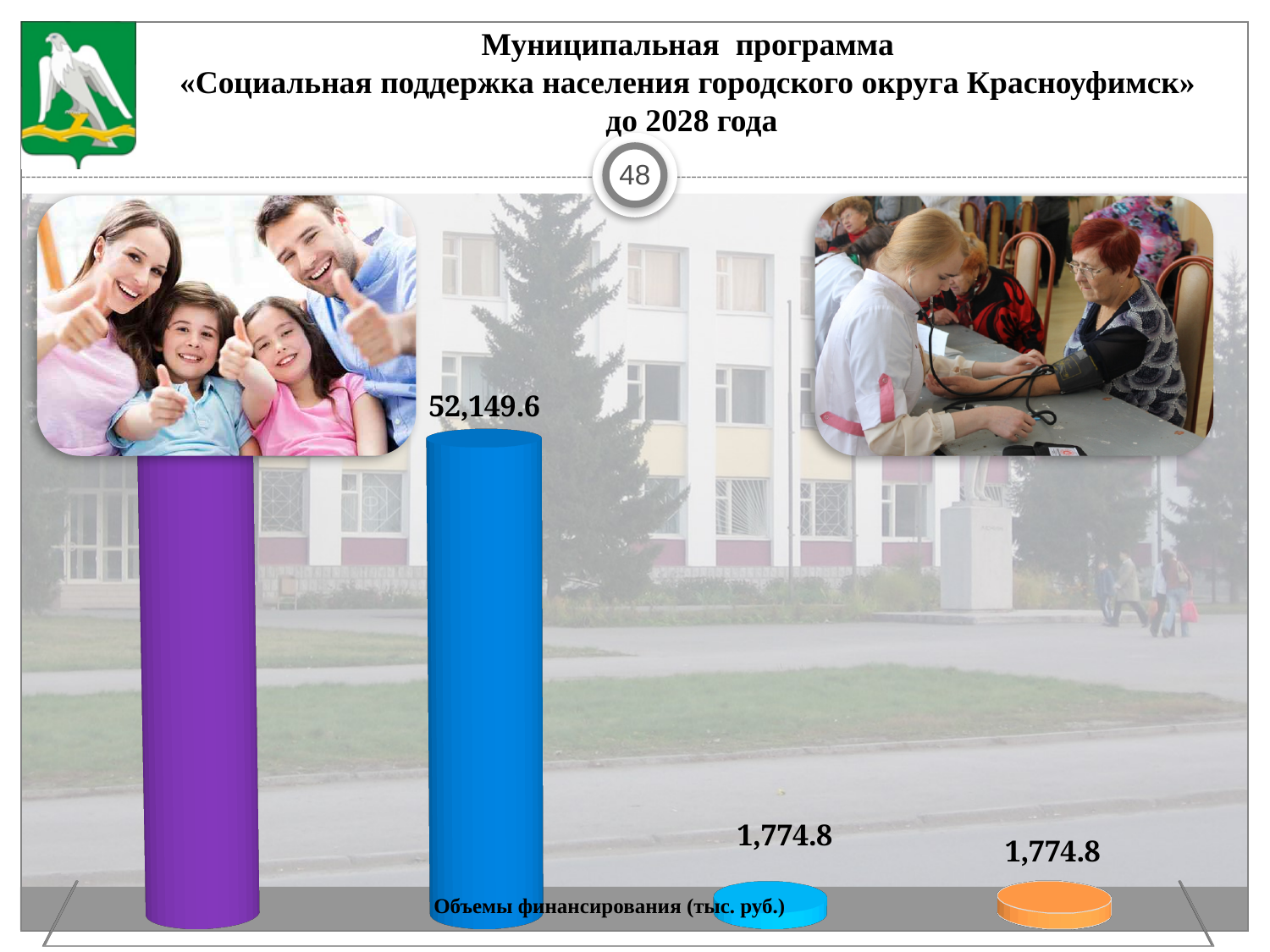
What colour is the bar labelled 52,149.6? blue Is the value of the blue bar greater or less than 50,000? greater What is the difference between the blue bar's value and the orange bar's value? 50,374.8 What text is printed along the base of the chart? Объемы финансирования (тыс. руб.) What is the lowest value printed on the chart? 1,774.8 What value is printed above the blue bar? 52,149.6 What value is printed above the orange bar? 1,774.8 What value is printed above the light blue bar (third from the left)? 1,774.8 What kind of chart is shown on the slide? bar chart Which is larger, the value of the blue bar or the value of the orange bar? the blue bar How many bars are plotted on the chart? 4